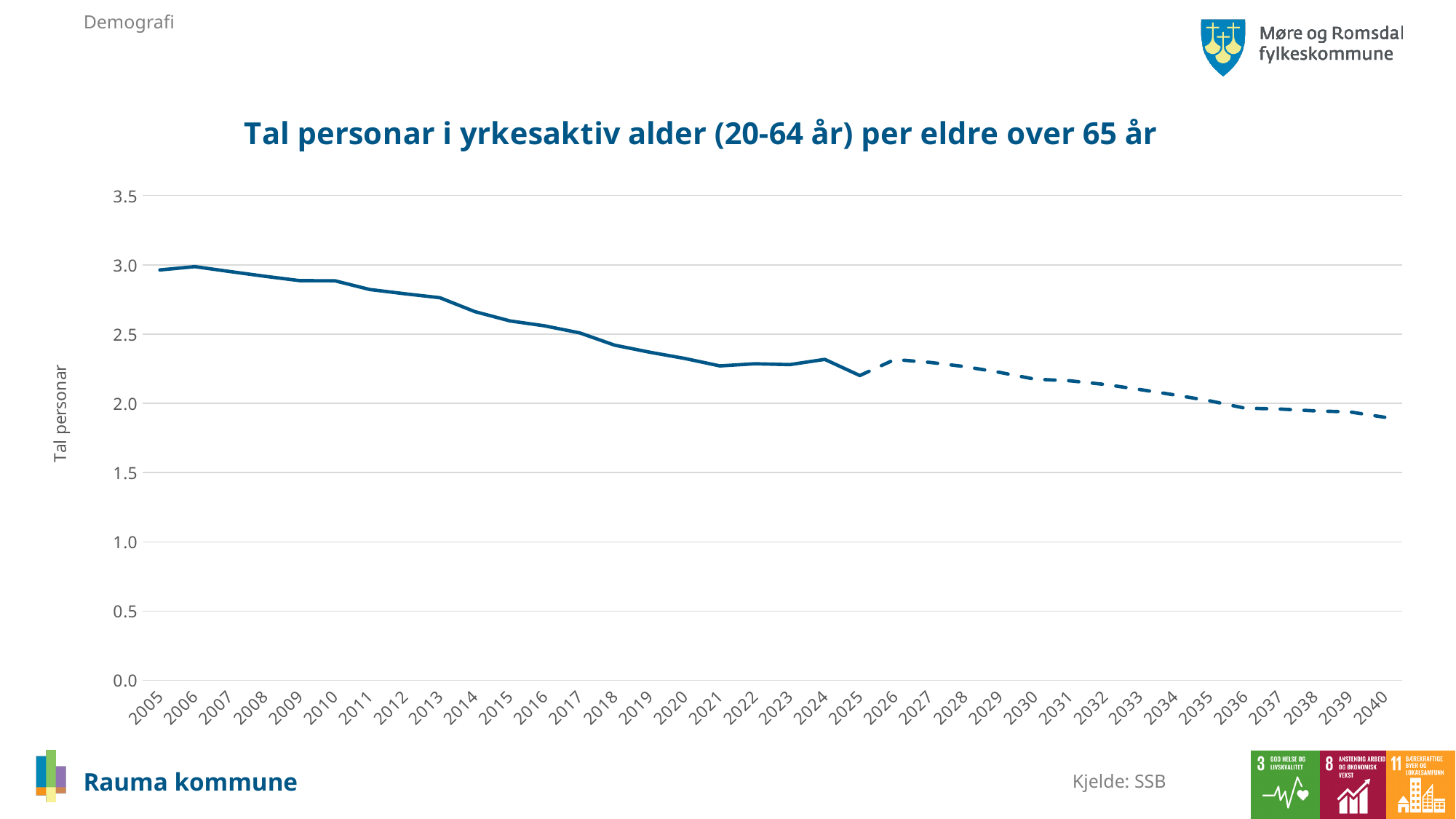
Which year has a higher value, 2010 or 2020? 2010 Is the value for 2010 greater or less than 3.0? less Is the value for 2040 greater or less than 2.0? less What is the label on the vertical axis of the chart? Tal personar What kind of chart is shown on the slide? line chart Do the values generally rise or fall from 2005 to 2040? fall Is the value for 2020 greater or less than 2.0? greater How many years are shown along the x axis of the chart? 36 Which year has a higher value, 2030 or 2013? 2013 What is the title of the chart? Tal personar i yrkesaktiv alder (20-64 år) per eldre over 65 år